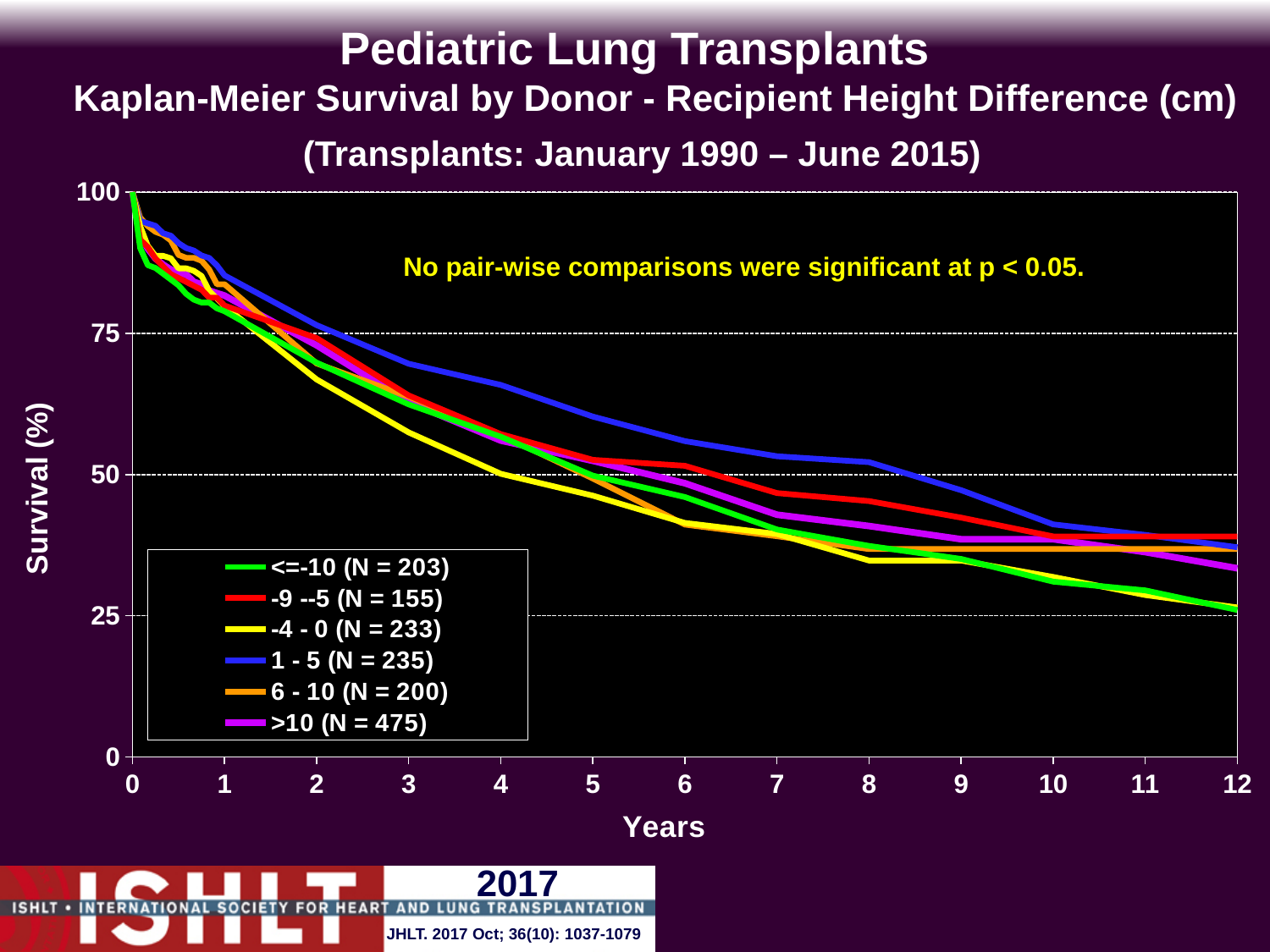
What is the N for the >10 height difference group in the legend? 475 Is the survival for the <=-10 group at year 12 greater or less than 50? less How many series does the legend list? 6 What kind of chart is shown on the slide? Line chart Which group has the highest survival at year 3? 1 - 5 Which height difference group has the largest N in the legend? >10 (N = 475) At year 3, which group has higher survival: 1 - 5 or -4 - 0? 1 - 5 What is the survival percentage for all groups at year 0? 100 Is the survival for the 1 - 5 group at year 3 greater or less than 50? greater Do the survival curves rise or fall as years increase? Fall Which height difference group has the smallest N in the legend? -9 --5 (N = 155)